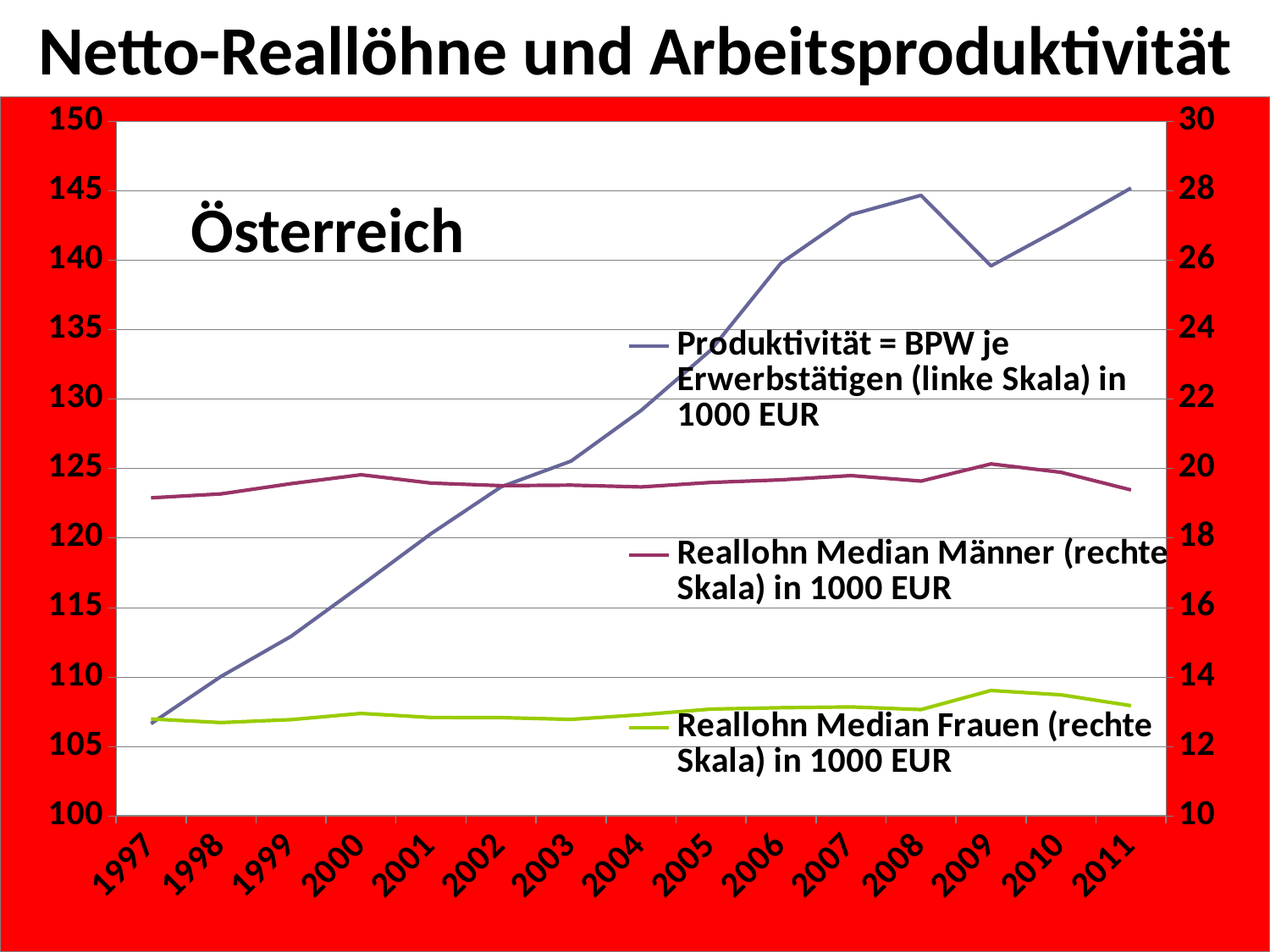
Is the value for Reallohn Median Männer in 2011 greater or less than 20? less Which year has the higher Produktivität value, 2007 or 2009? 2007 Is the value for Produktivität in 1997 greater or less than 110? less In which year is the Produktivität series at its lowest? 1997 What is the title of the slide? Netto-Reallöhne und Arbeitsproduktivität How many years are shown on the x axis? 15 Is the value for Reallohn Median Frauen in 2009 greater or less than 14? less In which year is the Reallohn Median Frauen series at its highest? 2009 Which country label is printed inside the chart area? Österreich What kind of chart is shown on the slide? line chart How many series does the legend list? 3